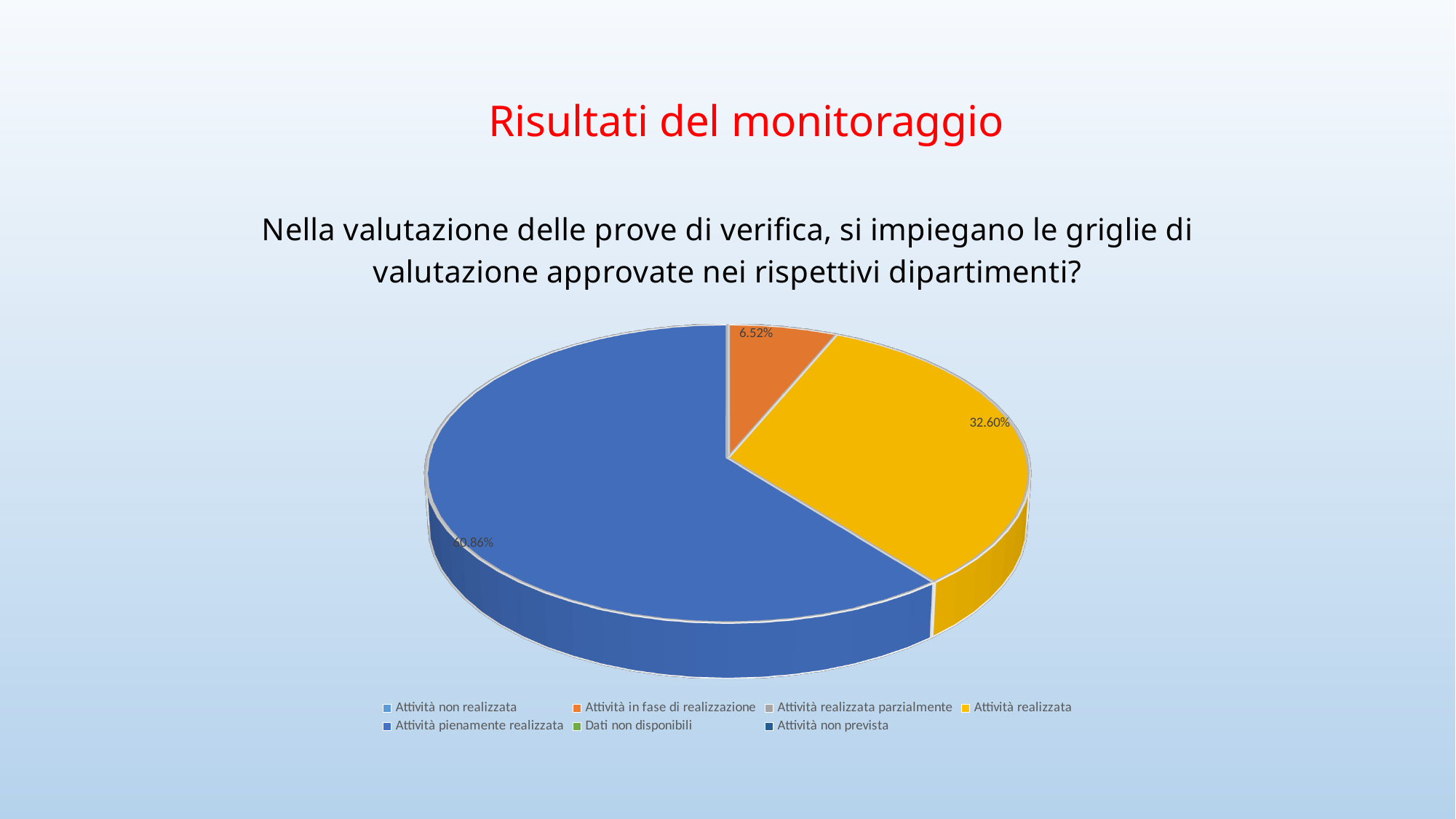
Which is larger: the "Attività realizzata" slice or the "Attività in fase di realizzazione" slice? Attività realizzata How many entries does the legend list? 7 Which of the labelled slices is the smallest? Attività in fase di realizzazione What colour is the "Attività realizzata" slice? Yellow How many slices with data labels are visible in the pie chart? 3 What is the difference between the "Attività pienamente realizzata" and "Attività realizzata" percentages? 28.26% Which category has the largest slice of the pie? Attività pienamente realizzata What percentage is shown for the "Attività realizzata" slice? 32.60% What percentage is shown for the "Attività pienamente realizzata" slice? 60.86% What question is the pie chart answering, according to the text above it? Nella valutazione delle prove di verifica, si impiegano le griglie di valutazione approvate nei rispettivi dipartimenti? What kind of chart is shown on the slide? Pie chart What percentage is shown for the "Attività in fase di realizzazione" slice? 6.52%